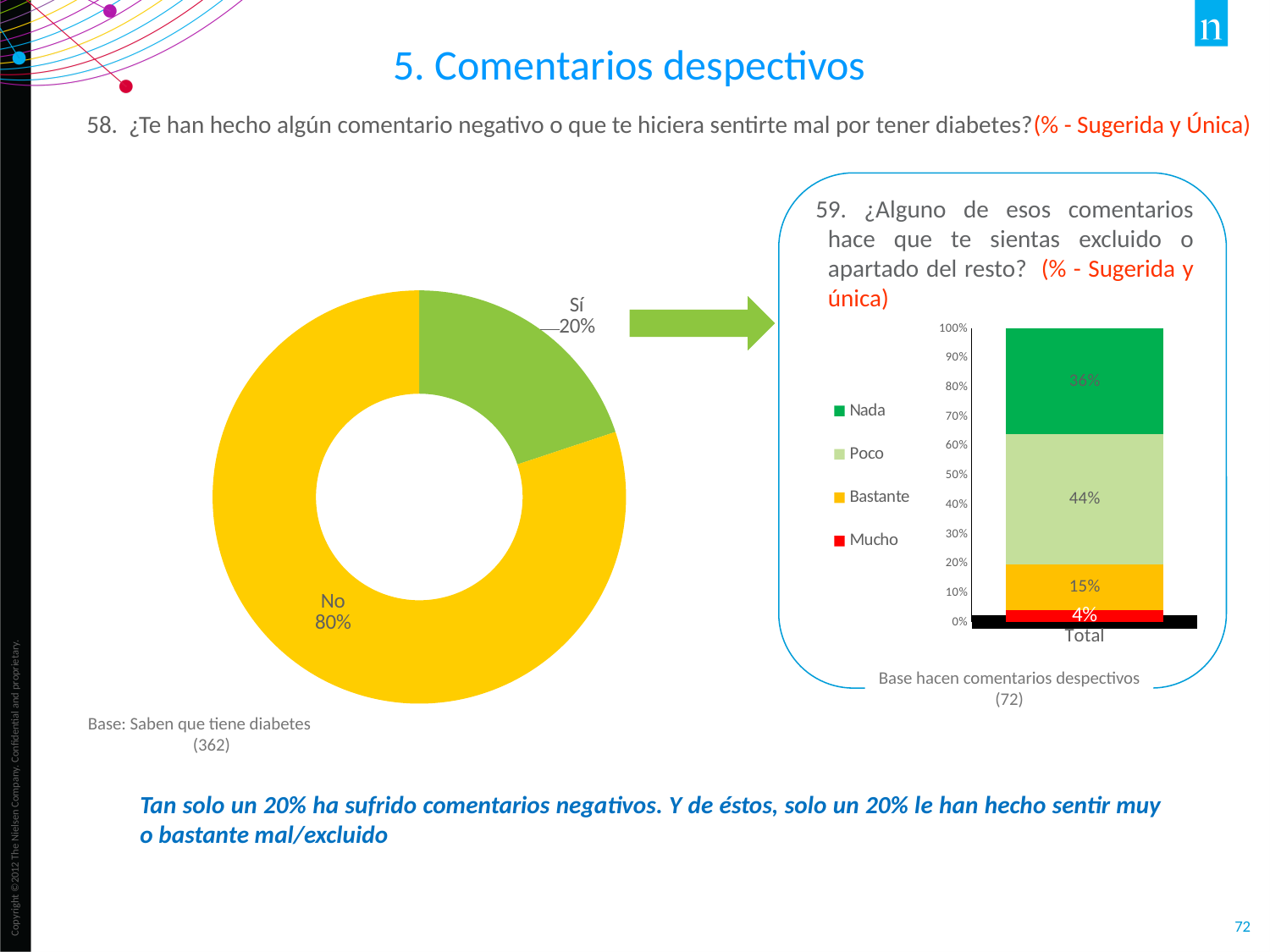
In the stacked bar chart on the right, what is the difference in percentage points between "Bastante" and "Mucho"? 11 What type of chart is shown on the left of the slide? Pie (donut) chart In the donut chart on the left, what is the difference in percentage points between "No" and "Sí"? 60 In the donut chart on the left, what percentage answered "Sí"? 20% In the stacked bar chart on the right, which series has the largest value? Poco In the donut chart on the left, what percentage answered "No"? 80% In the donut chart on the left, which answer has the larger share, "Sí" or "No"? No In the stacked bar chart on the right, which series has the smallest value? Mucho In the stacked bar chart on the right, what is the value for "Poco"? 44% How many series does the legend of the stacked bar chart on the right list? 4 In the stacked bar chart on the right, what is the value for "Nada"? 36% In the stacked bar chart on the right, what is the value for "Mucho"? 4%